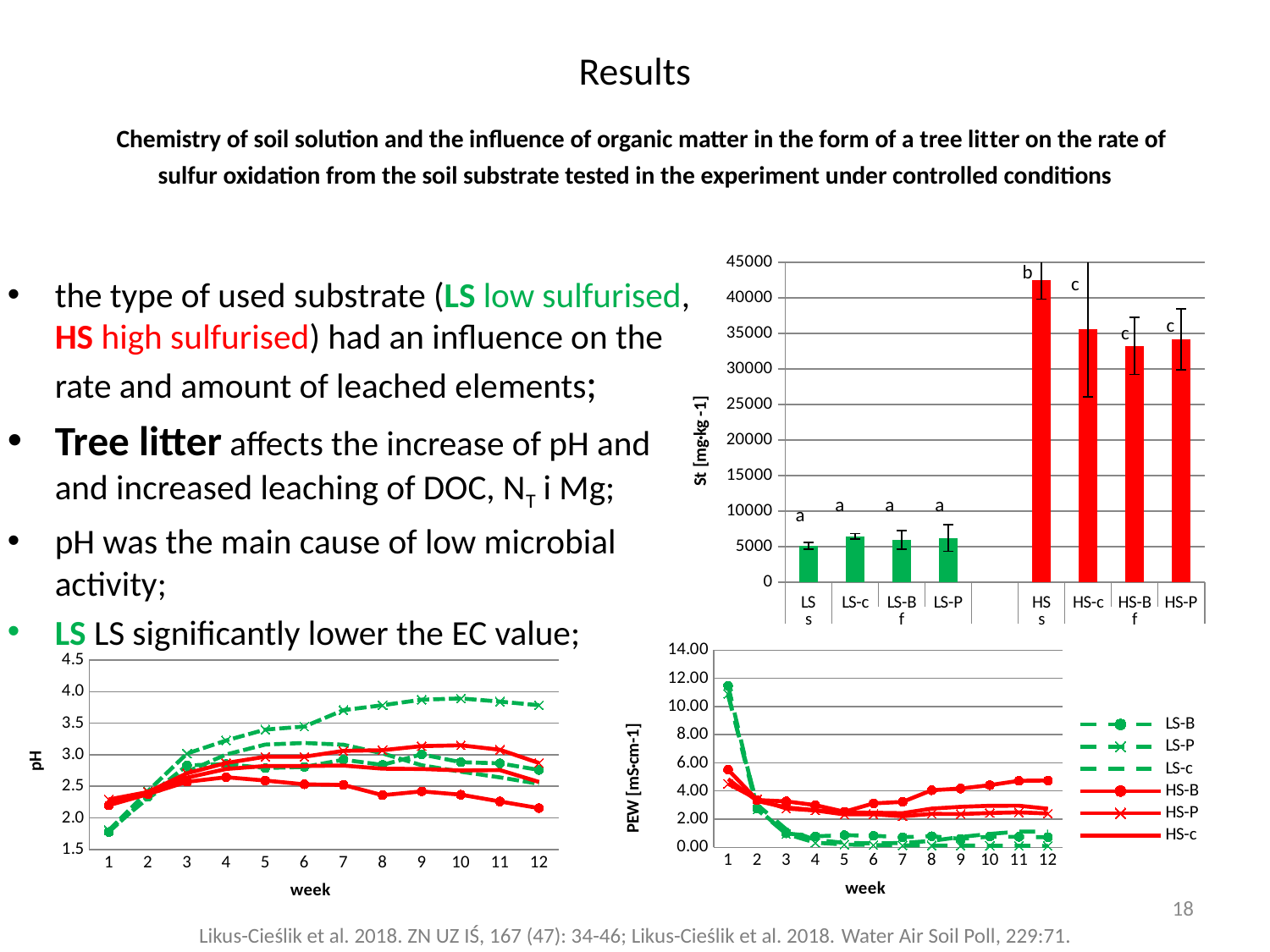
In the bar chart at the top right (St [mg·kg-1]), is the value for HS-c greater or less than 30000? greater In the bar chart at the top right (St [mg·kg-1]), which is larger, the value for HS s or the value for HS-P? HS s In the bar chart at the top right (St [mg·kg-1]), which category has the highest value? HS s How many series does the legend of the PEW [mS·cm-1] chart at the bottom right list? 6 What kind of chart is the chart at the top right with the y axis labelled St [mg·kg-1]? bar chart How many weeks are shown on the x axis of the pH chart at the bottom left? 12 In the bar chart at the top right (St [mg·kg-1]), is the value for HS s greater or less than 40000? greater In the PEW [mS·cm-1] chart at the bottom right, does the LS-B series rise or fall from week 1 to week 12? fall In the bar chart at the top right (St [mg·kg-1]), is the value for LS s greater or less than 10000? less How many categories are shown on the x axis of the bar chart at the top right (St [mg·kg-1])? 8 What kind of chart is the PEW [mS·cm-1] chart at the bottom right? line chart In the bar chart at the top right (St [mg·kg-1]), which category has the lowest value? LS s